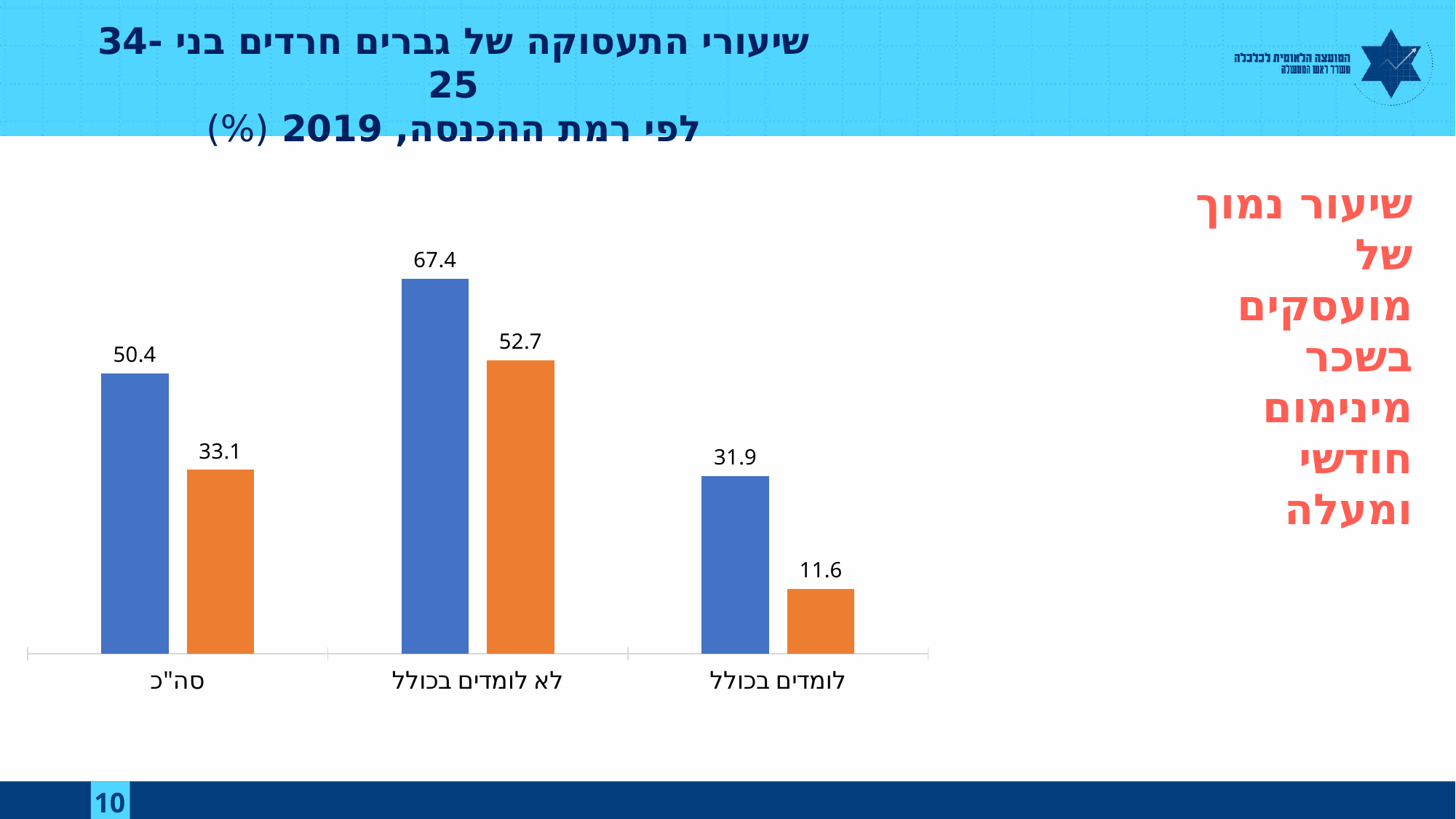
What type of chart is shown on the slide? bar chart Which category has the highest blue bar? לא לומדים בכולל Which category has the lowest orange bar? לומדים בכולל How many categories are shown on the x axis of the chart? 3 What is the value of the blue bar for the category סה"כ? 50.4 What is the difference between the blue bar values for לא לומדים בכולל and לומדים בכולל? 35.5 What is the value of the blue bar for the category לא לומדים בכולל? 67.4 For the category לא לומדים בכולל, which bar is larger, the blue or the orange? blue What is the value of the orange bar for the category לומדים בכולל? 11.6 What is the value of the orange bar for the category סה"כ? 33.1 What year is stated in the chart title on the slide? 2019 What is the difference between the blue and orange bars for the category לומדים בכולל? 20.3